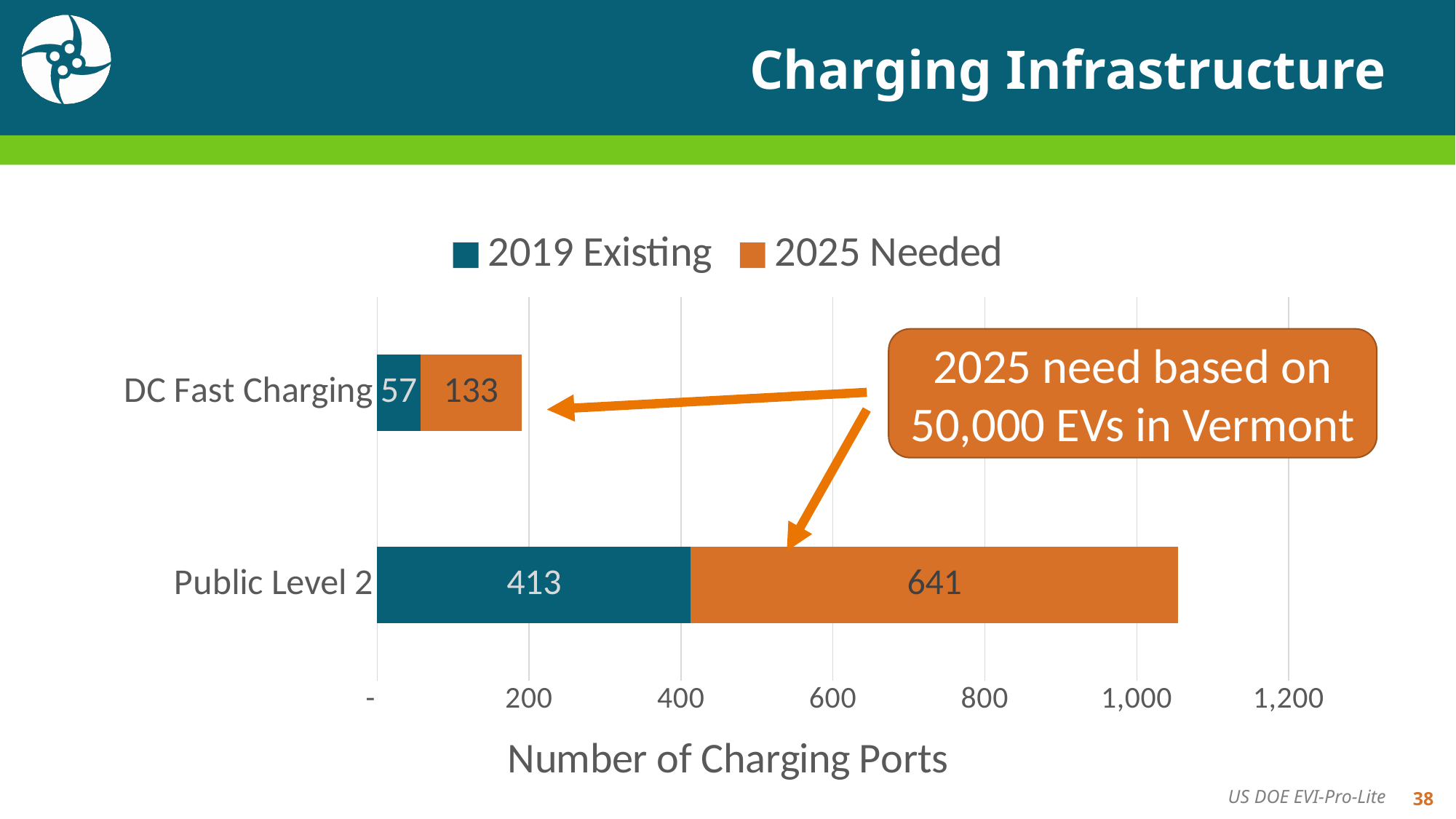
What kind of chart is shown on the slide? Stacked bar chart How many categories are shown on the chart? 2 How many series does the legend list? 2 What is the 2025 Needed value for DC Fast Charging? 133 What is the total length of the stacked bar for Public Level 2? 1,054 What is the total length of the stacked bar for DC Fast Charging? 190 Is the 2019 Existing value for Public Level 2 greater or less than the 2025 Needed value for Public Level 2? less What is the 2019 Existing value for Public Level 2? 413 Which category has the larger 2019 Existing value? Public Level 2 What is the 2025 Needed value for Public Level 2? 641 What is the difference between the 2025 Needed values for Public Level 2 and DC Fast Charging? 508 What is the 2019 Existing value for DC Fast Charging? 57